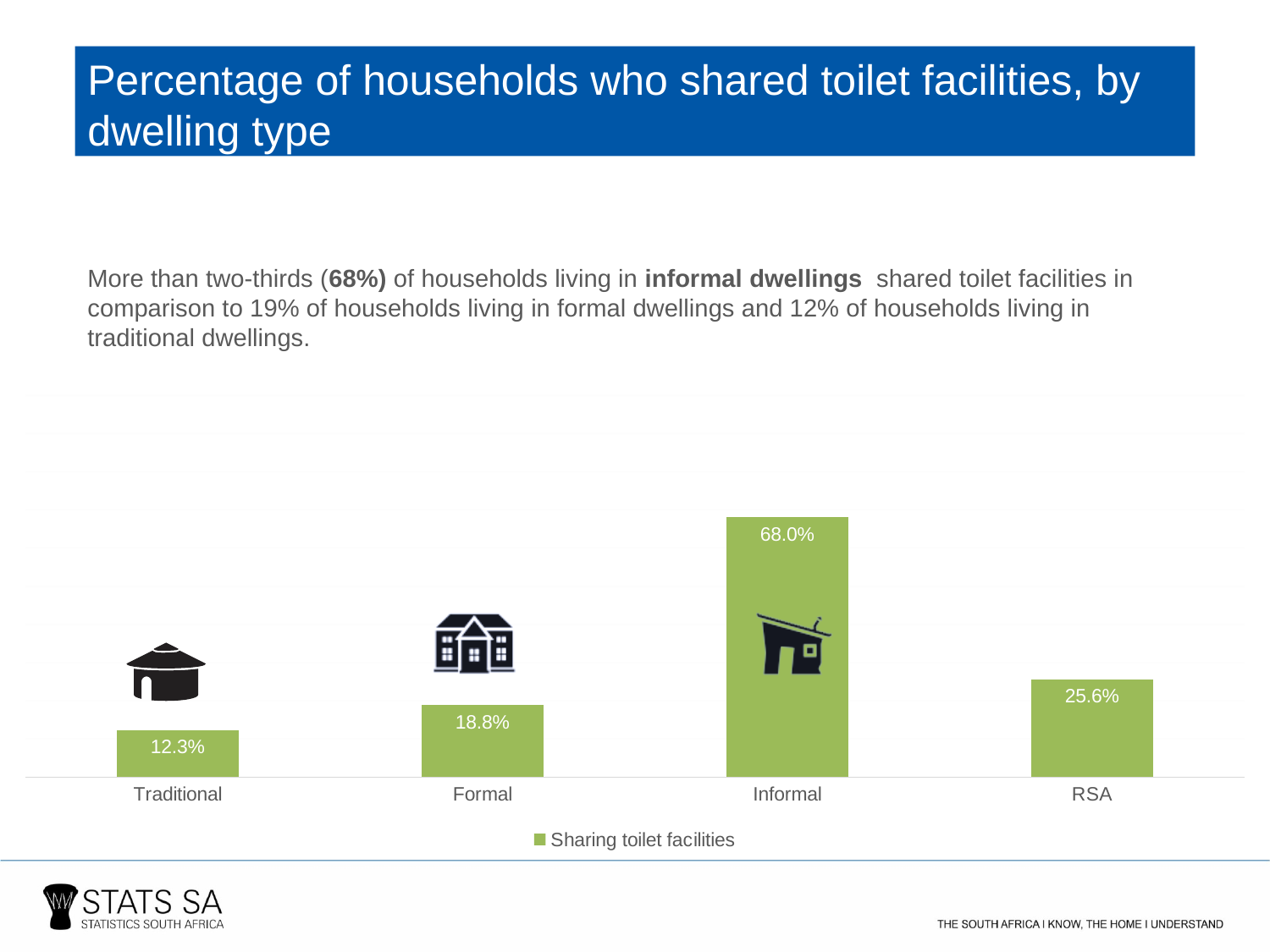
What series name does the legend show? Sharing toilet facilities What percentage of households in informal dwellings shared toilet facilities? 68.0% How many dwelling categories are shown on the x axis? 4 What is the value shown for Traditional dwellings? 12.3% What is the value shown for Formal dwellings? 18.8% What is the value shown for RSA? 25.6% What is the difference in percentage points between Informal and Formal dwellings? 49.2 Which dwelling type has the lowest percentage of households sharing toilet facilities? Traditional Which dwelling type has the highest percentage of households sharing toilet facilities? Informal What type of chart is shown on the slide? Bar chart What is the difference in percentage points between RSA and Traditional dwellings? 13.3 Which is larger, the value for Formal or the value for RSA? RSA